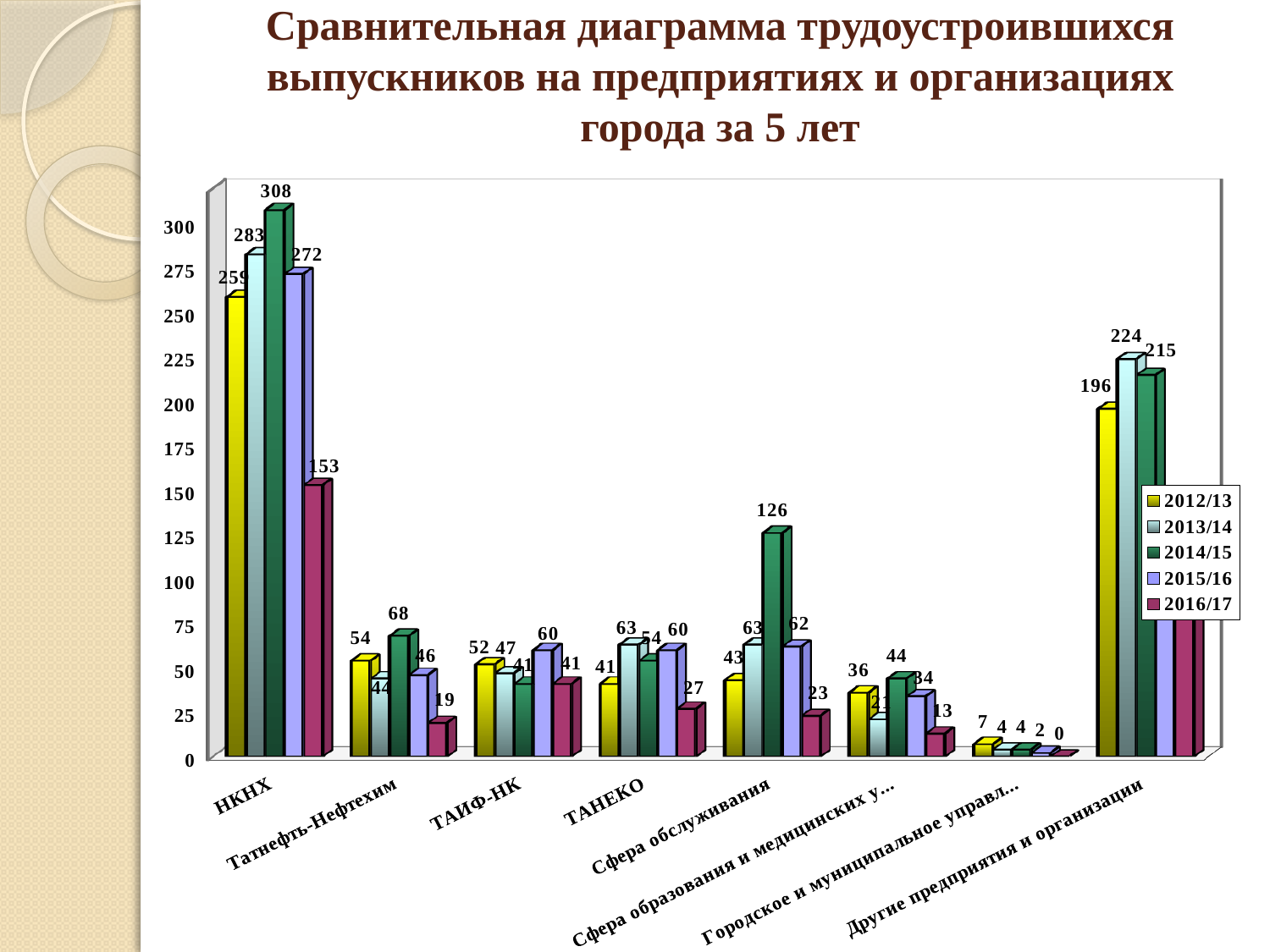
For ТАНЕКО, which is larger: the 2013/14 value or the 2015/16 value? 2013/14 What is the value for Сфера обслуживания in the 2014/15 series? 126 Which series has the lowest value for НКНХ? 2016/17 Which category has the highest value in the 2014/15 series? НКНХ What kind of chart is shown on the slide? bar chart How many series does the legend list? 5 How many categories are shown on the x axis? 8 What is the value for НКНХ in the 2014/15 series? 308 What is the difference between the 2014/15 and 2013/14 values for Сфера обслуживания? 63 Is the 2012/13 value for Другие предприятия и организации greater or less than 200? less What is the difference between the 2014/15 and 2012/13 values for НКНХ? 49 What is the value for ТАИФ-НК in the 2015/16 series? 60